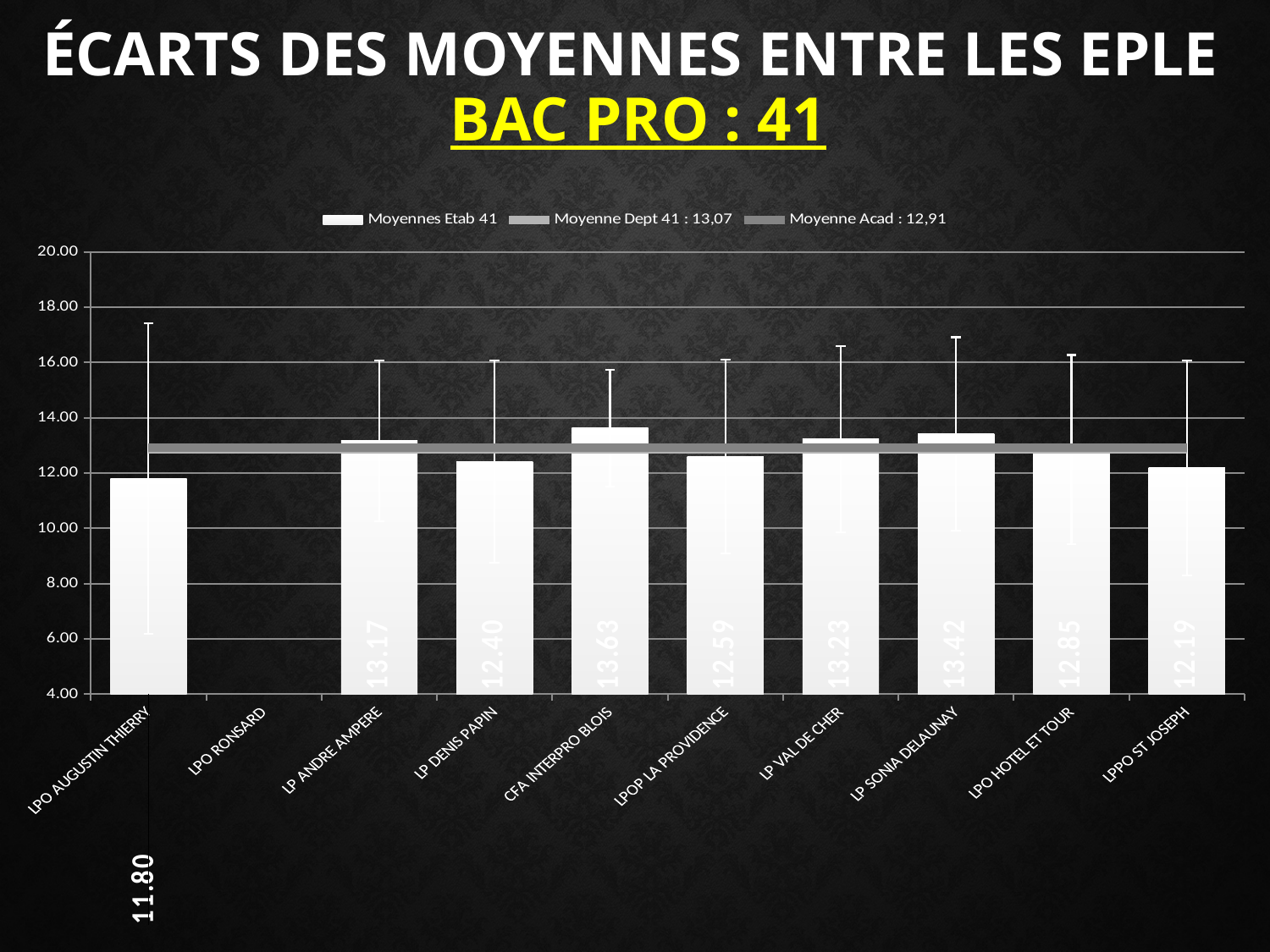
What kind of chart is shown on the slide? combination bar and line chart What is the value for LPO HOTEL ET TOUR? 12.85 What is the value for LPO AUGUSTIN THIERRY? 11.80 Is the value for LPO AUGUSTIN THIERRY greater or less than 12.00? less What is the difference between the values for LP VAL DE CHER and LPOP LA PROVIDENCE? 0.64 How many establishments are listed on the x axis? 10 Which establishment has the highest value? CFA INTERPRO BLOIS Which is larger, the value for LP ANDRE AMPERE or LP DENIS PAPIN? LP ANDRE AMPERE What is the difference between the values for CFA INTERPRO BLOIS and LPO AUGUSTIN THIERRY? 1.83 What is the value for CFA INTERPRO BLOIS? 13.63 How many series does the legend list? 3 Which establishment has the lowest plotted value? LPO AUGUSTIN THIERRY